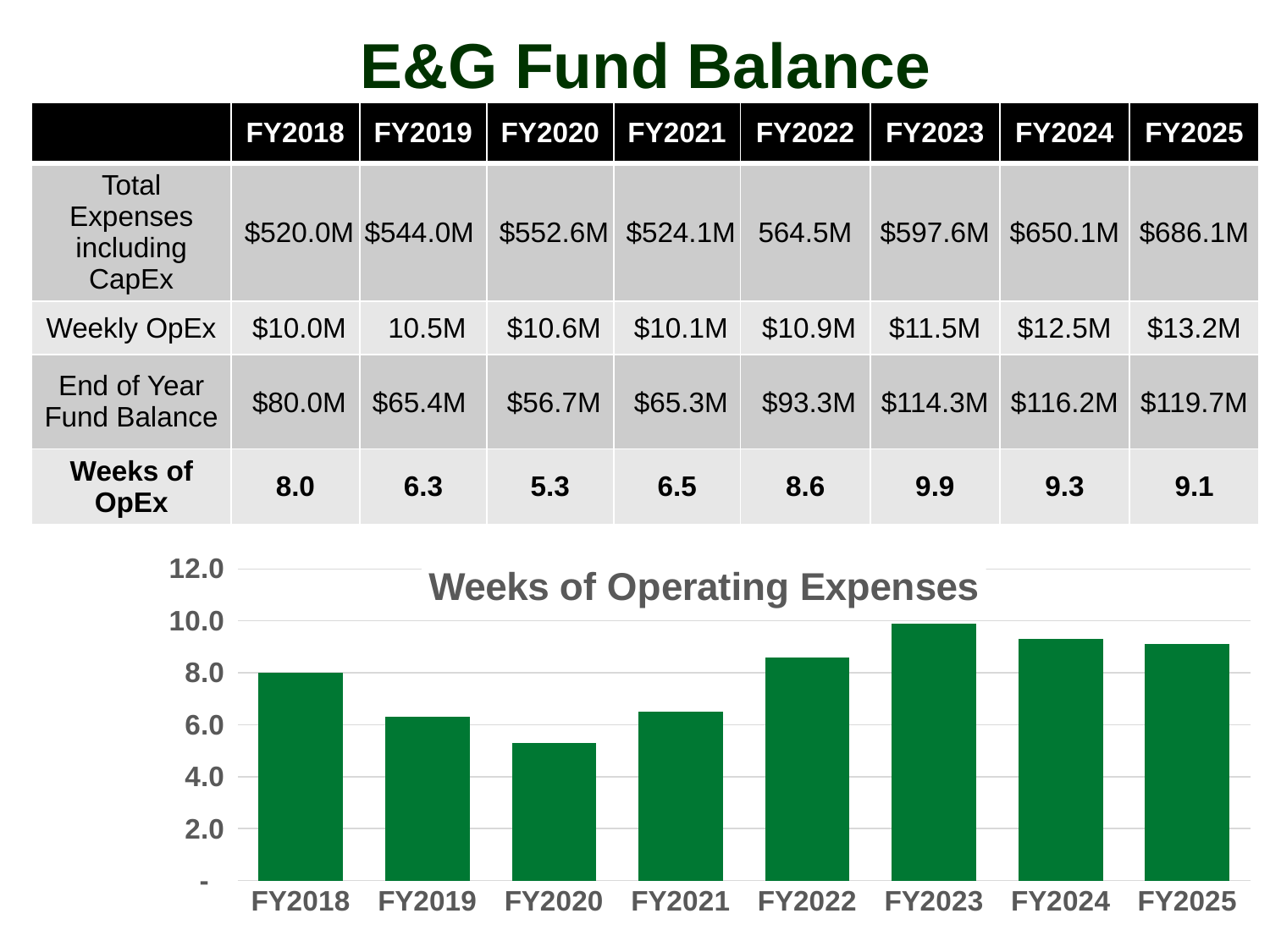
What is the title of the chart? Weeks of Operating Expenses Which is larger in the Weeks of Operating Expenses chart, FY2018 or FY2022? FY2022 How many fiscal years are plotted in the Weeks of Operating Expenses chart? 8 Which fiscal year has the highest value in the Weeks of Operating Expenses chart? FY2023 Do the values in the Weeks of Operating Expenses chart rise or fall from FY2020 to FY2023? rise What is the value for FY2023 in the Weeks of Operating Expenses chart? 9.9 What kind of chart is shown on the slide? bar chart What colour are the bars in the Weeks of Operating Expenses chart? green What is the difference between the FY2023 and FY2020 values in the Weeks of Operating Expenses chart? 4.6 Is the value for FY2024 in the Weeks of Operating Expenses chart greater or less than 8.0? greater Which fiscal year has the lowest value in the Weeks of Operating Expenses chart? FY2020 What is the value for FY2020 in the Weeks of Operating Expenses chart? 5.3